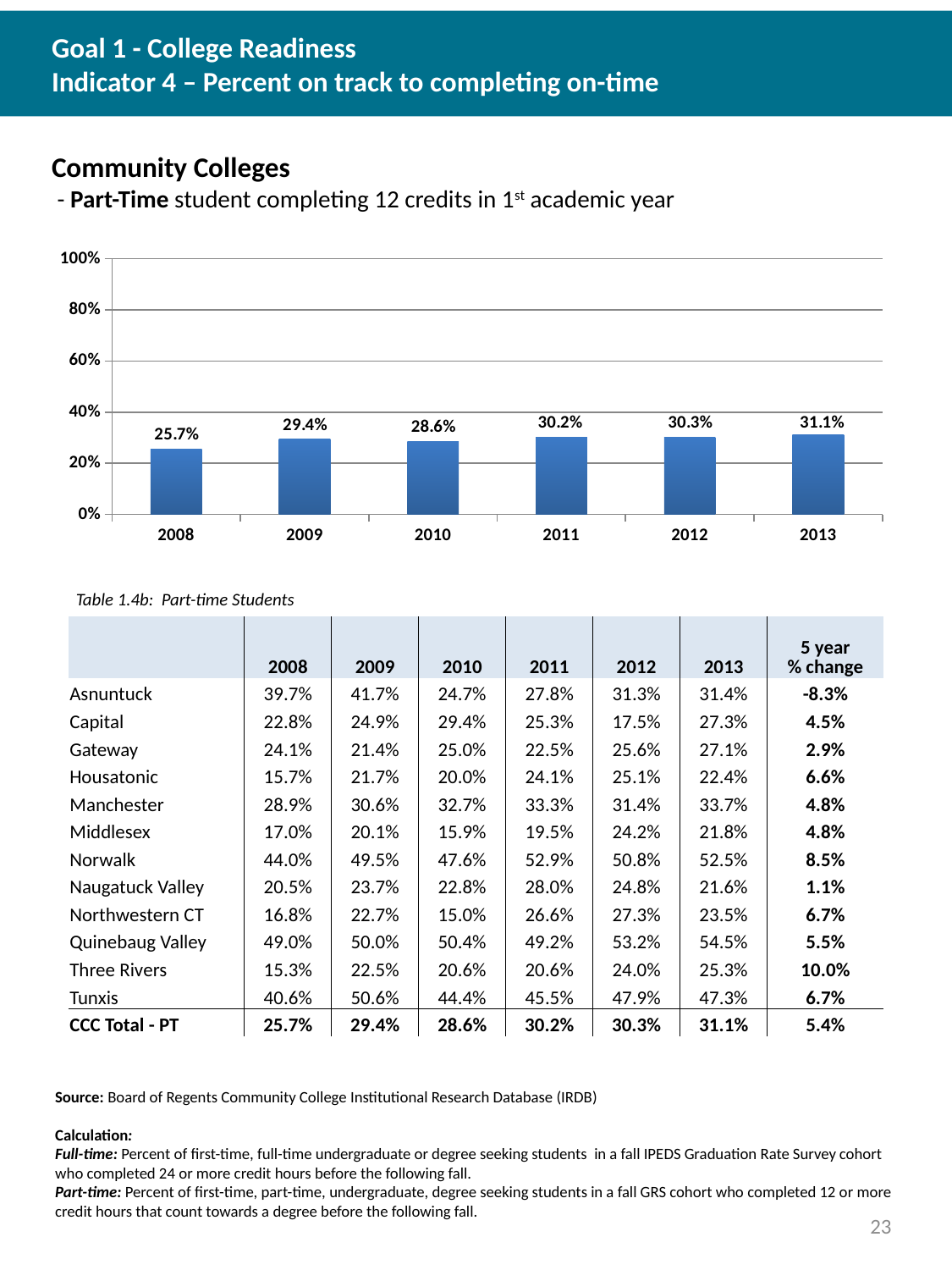
What is the difference between the 2013 value and the 2008 value in the bar chart? 5.4% What kind of chart is shown on the slide? bar chart Which year has the lowest value in the bar chart? 2008 What is the value for 2013 in the bar chart? 31.1% What is the highest value shown on the y axis of the bar chart? 100% What is the value for 2008 in the bar chart? 25.7% What is the difference between the 2009 value and the 2010 value in the bar chart? 0.8% How many years are shown on the x axis of the bar chart? 6 Which is larger in the bar chart, the value for 2009 or the value for 2008? 2009 Is the value for 2011 in the bar chart greater or less than 40%? less Which year has the highest value in the bar chart? 2013 What is the value for 2010 in the bar chart? 28.6%